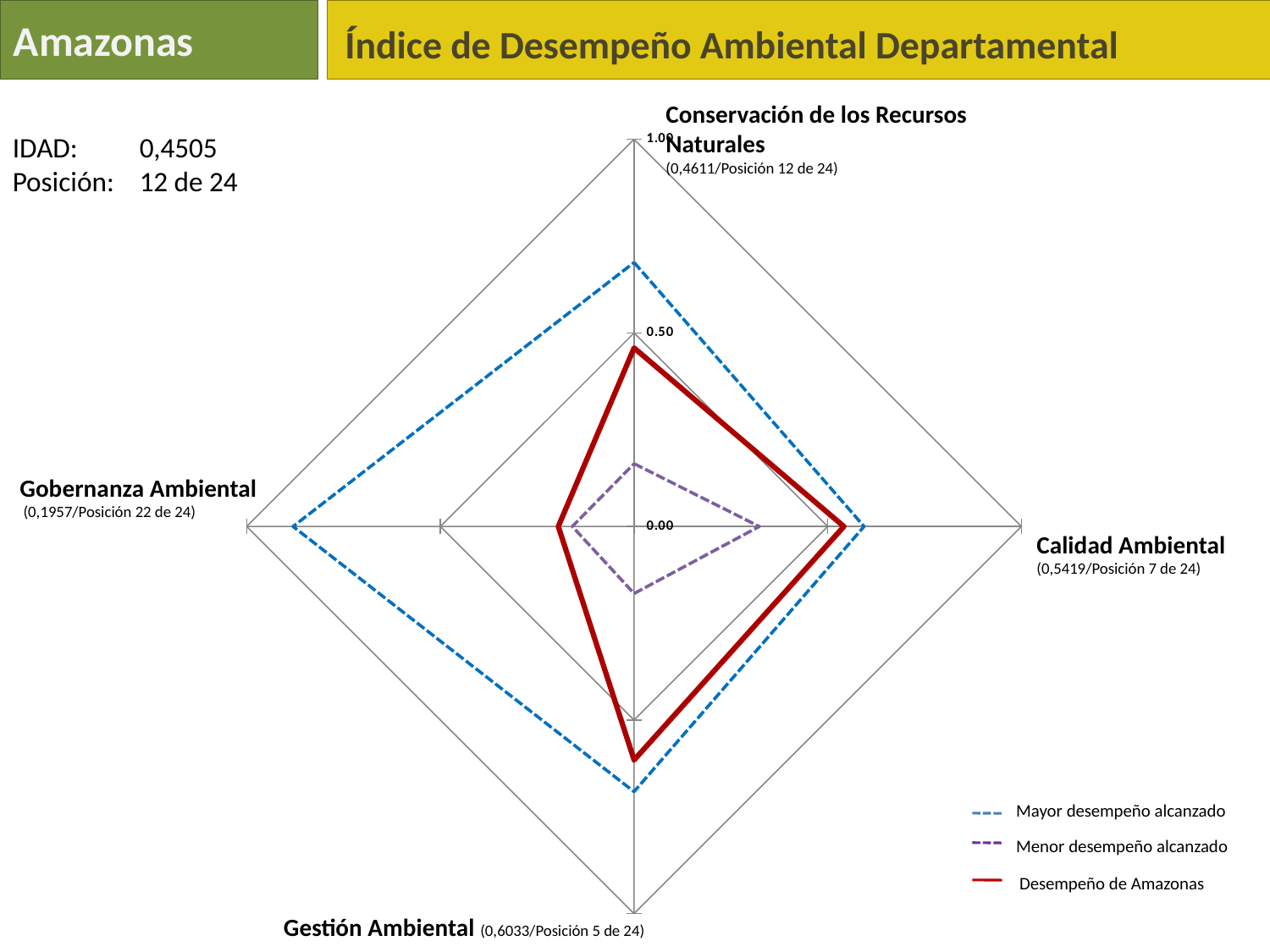
What type of chart is shown on the slide? Radar chart On which axis does Amazonas have its highest value? Gestión Ambiental On which axis does Amazonas have its lowest value? Gobernanza Ambiental Which is larger for Amazonas: Calidad Ambiental or Conservación de los Recursos Naturales? Calidad Ambiental Is the Menor desempeño alcanzado value for Conservación de los Recursos Naturales greater or less than 0.50? less What is the difference between the Amazonas values for Gestión Ambiental and Gobernanza Ambiental? 0,4076 What is the Desempeño de Amazonas value for Gestión Ambiental? 0,6033 Is the Mayor desempeño alcanzado value for Gobernanza Ambiental greater or less than 0.50? greater What is the Desempeño de Amazonas value for Calidad Ambiental? 0,5419 What is the Desempeño de Amazonas value for Conservación de los Recursos Naturales? 0,4611 How many series does the legend list? 3 What is the Desempeño de Amazonas value for Gobernanza Ambiental? 0,1957